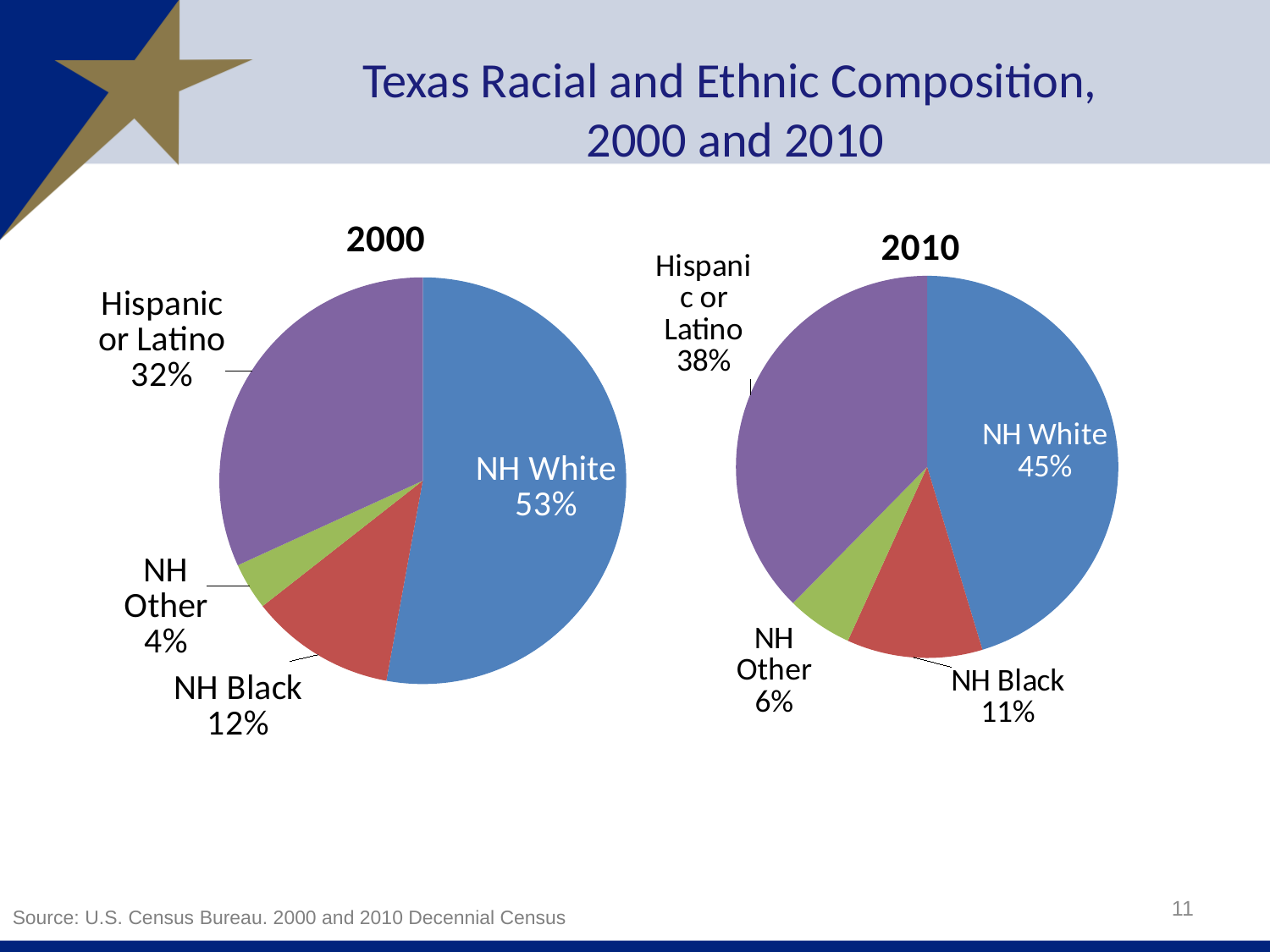
In the 2010 pie chart, what share is NH Other? 6% In the 2010 pie chart, what is the difference between the NH White and Hispanic or Latino shares? 7 percentage points What is the difference between the NH White share in 2000 and in 2010? 8 percentage points What type of chart is used on this slide? Pie chart In the 2010 pie chart, what share is Hispanic or Latino? 38% In the 2000 pie chart, what share is NH White? 53% In the 2000 pie chart, what share is NH Black? 12% In the 2010 pie chart, which category has the smallest share? NH Other What is the title of the slide's charts? Texas Racial and Ethnic Composition, 2000 and 2010 Which is larger: the Hispanic or Latino share in 2000 or in 2010? 2010 In the 2000 pie chart, which category has the largest share? NH White How many categories does the 2000 pie chart show? 4